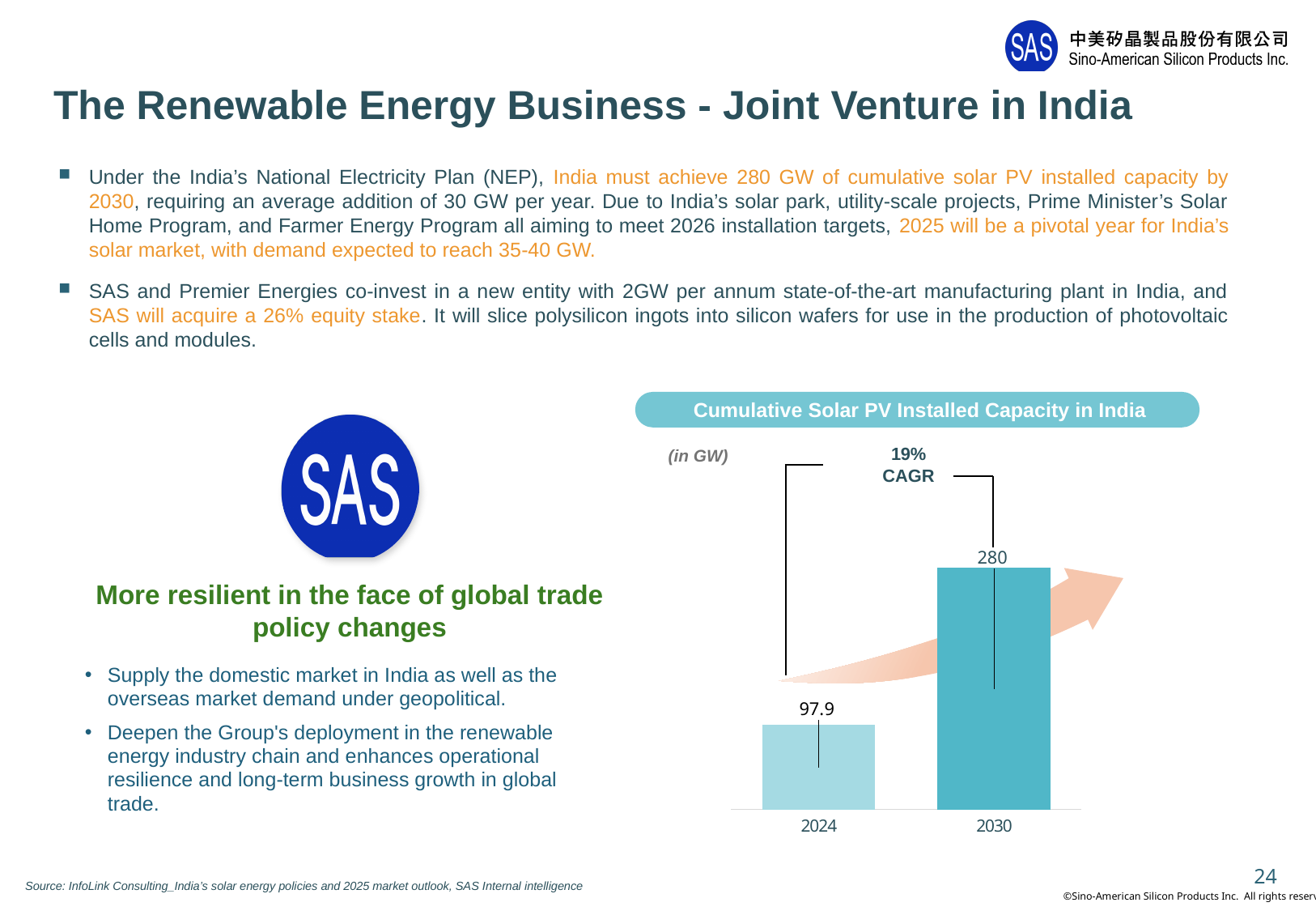
Which year has the higher cumulative solar PV installed capacity in the chart, 2024 or 2030? 2030 What is the cumulative solar PV installed capacity in India for 2024 according to the chart? 97.9 What unit are the values in the chart expressed in? GW What type of chart is used to show cumulative solar PV installed capacity in India? Bar chart What CAGR is annotated on the chart between 2024 and 2030? 19% What is the title of the chart? Cumulative Solar PV Installed Capacity in India Do the values in the chart rise or fall from 2024 to 2030? Rise How many years (categories) are shown in the chart? 2 What is the difference between the 2030 and 2024 values in the chart? 182.1 What is the cumulative solar PV installed capacity in India for 2030 according to the chart? 280 Which year shows the lowest value in the chart? 2024